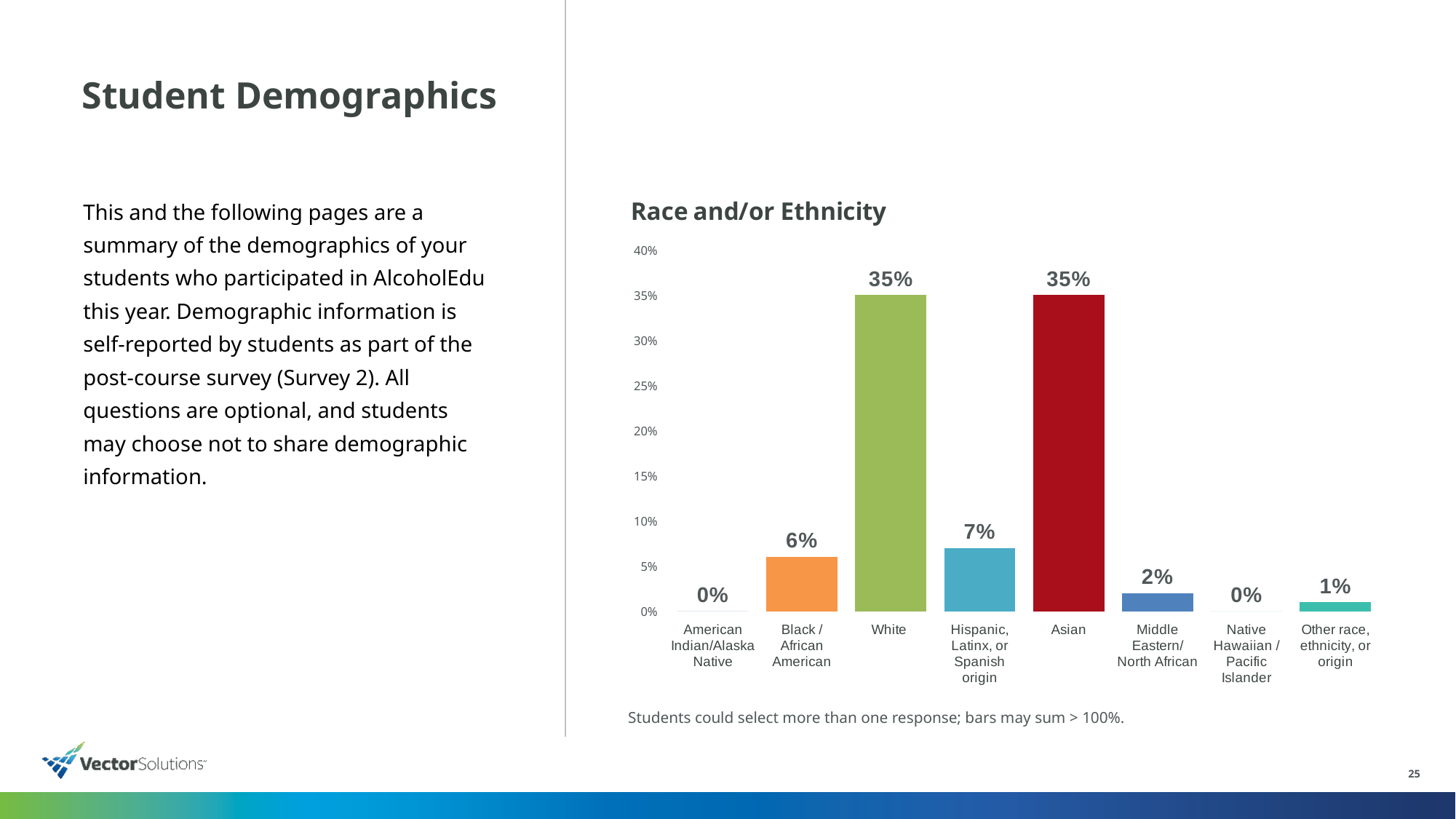
What is the value for Middle Eastern/North African in the Race and/or Ethnicity chart? 2% In the Race and/or Ethnicity chart, what is the difference between the Asian value and the Middle Eastern/North African value? 33% What is the value for Hispanic, Latinx, or Spanish origin in the Race and/or Ethnicity chart? 7% How many race/ethnicity categories are shown in the Race and/or Ethnicity chart? 8 In the Race and/or Ethnicity chart, what is the difference between the White value and the Hispanic, Latinx, or Spanish origin value? 28% What is the highest value shown in the Race and/or Ethnicity chart? 35% What is the value for Black / African American in the Race and/or Ethnicity chart? 6% What is the value for Other race, ethnicity, or origin in the Race and/or Ethnicity chart? 1% What percentage of students are shown as White in the Race and/or Ethnicity chart? 35% What type of chart is used to show Race and/or Ethnicity? Bar chart Is the value for Asian in the Race and/or Ethnicity chart greater or less than 30%? greater In the Race and/or Ethnicity chart, which is larger: Black / African American or Hispanic, Latinx, or Spanish origin? Hispanic, Latinx, or Spanish origin